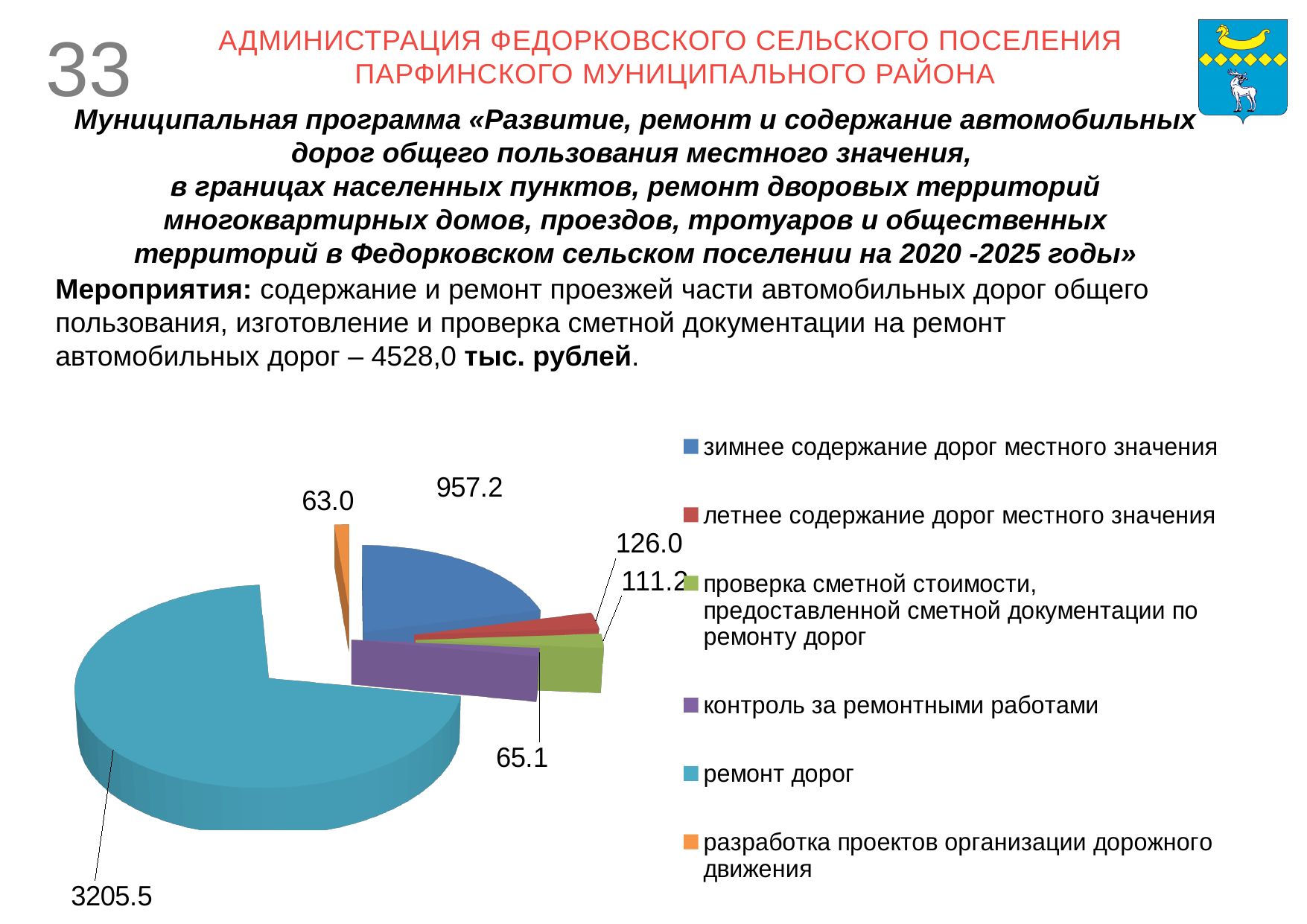
What kind of chart is shown on the slide? Pie chart What is the value for «зимнее содержание дорог местного значения»? 957.2 Which is larger: the value for «летнее содержание дорог местного значения» or for «проверка сметной стоимости, предоставленной сметной документации по ремонту дорог»? летнее содержание дорог местного значения What is the value for «контроль за ремонтными работами»? 65.1 Which category has the largest slice in the pie chart? ремонт дорог Which category has the smallest value in the pie chart? разработка проектов организации дорожного движения What is the value for «разработка проектов организации дорожного движения»? 63.0 How many slices does the pie chart have? 6 What is the difference between the values for «зимнее содержание дорог местного значения» and «летнее содержание дорог местного значения»? 831.2 What is the value for «ремонт дорог» in the pie chart? 3205.5 How many entries does the legend of the pie chart list? 6 What colour is the slice for «ремонт дорог» in the pie chart? Teal (light blue)